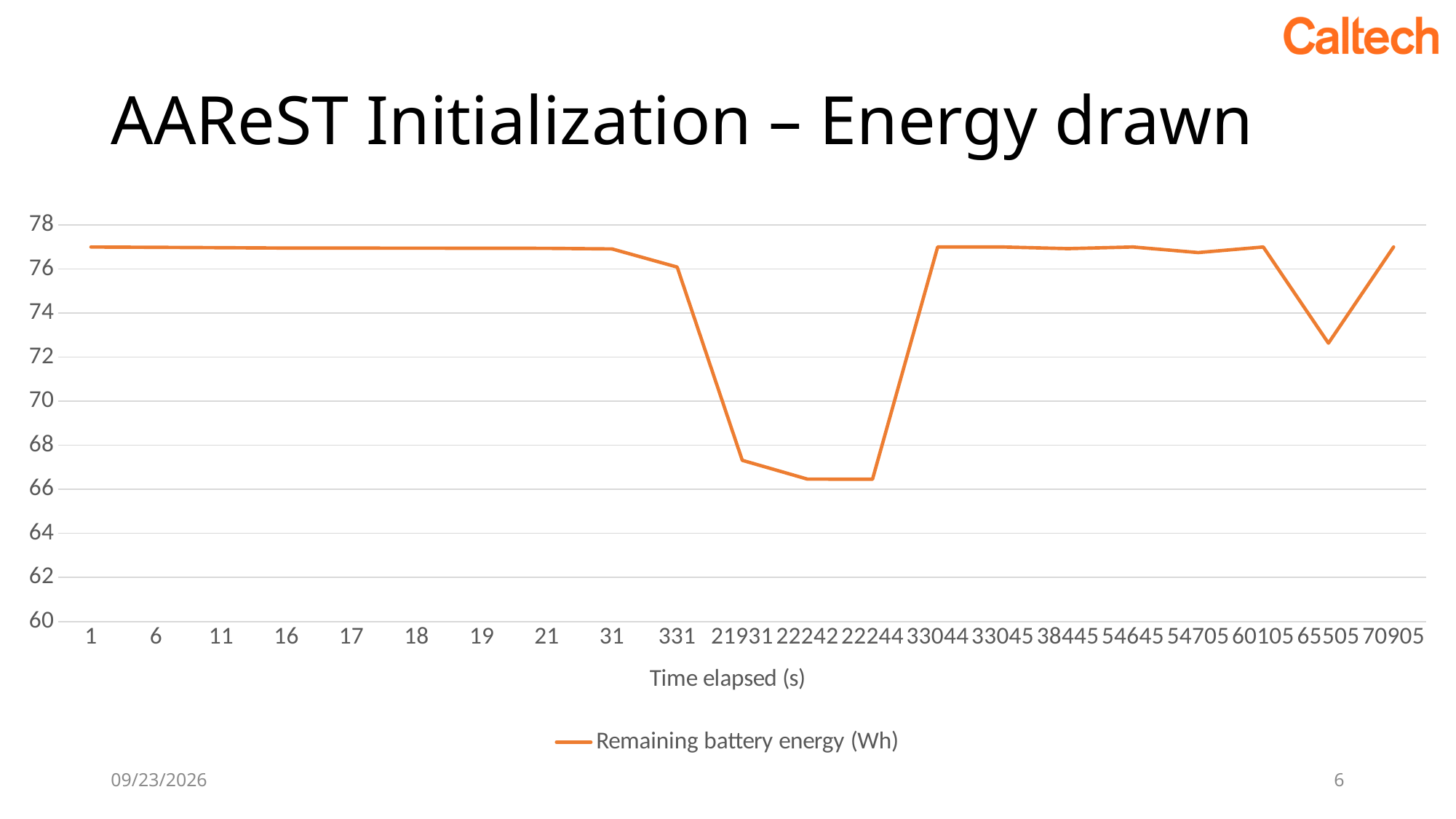
Is the remaining battery energy at time 65505 greater or less than 74? less Is the remaining battery energy at time 1 greater or less than 76? greater Which has the larger remaining battery energy, time 331 or time 21931? 331 How many series does the legend list? 1 Is the remaining battery energy at time 22242 greater or less than 68? less Which has the larger remaining battery energy, time 22242 or time 65505? 65505 How many time points are plotted along the x axis? 21 What kind of chart is shown on the slide? line chart What is the title of the x axis? Time elapsed (s) What series name does the legend show? Remaining battery energy (Wh) Does the remaining battery energy rise or fall between time 331 and time 22242? fall